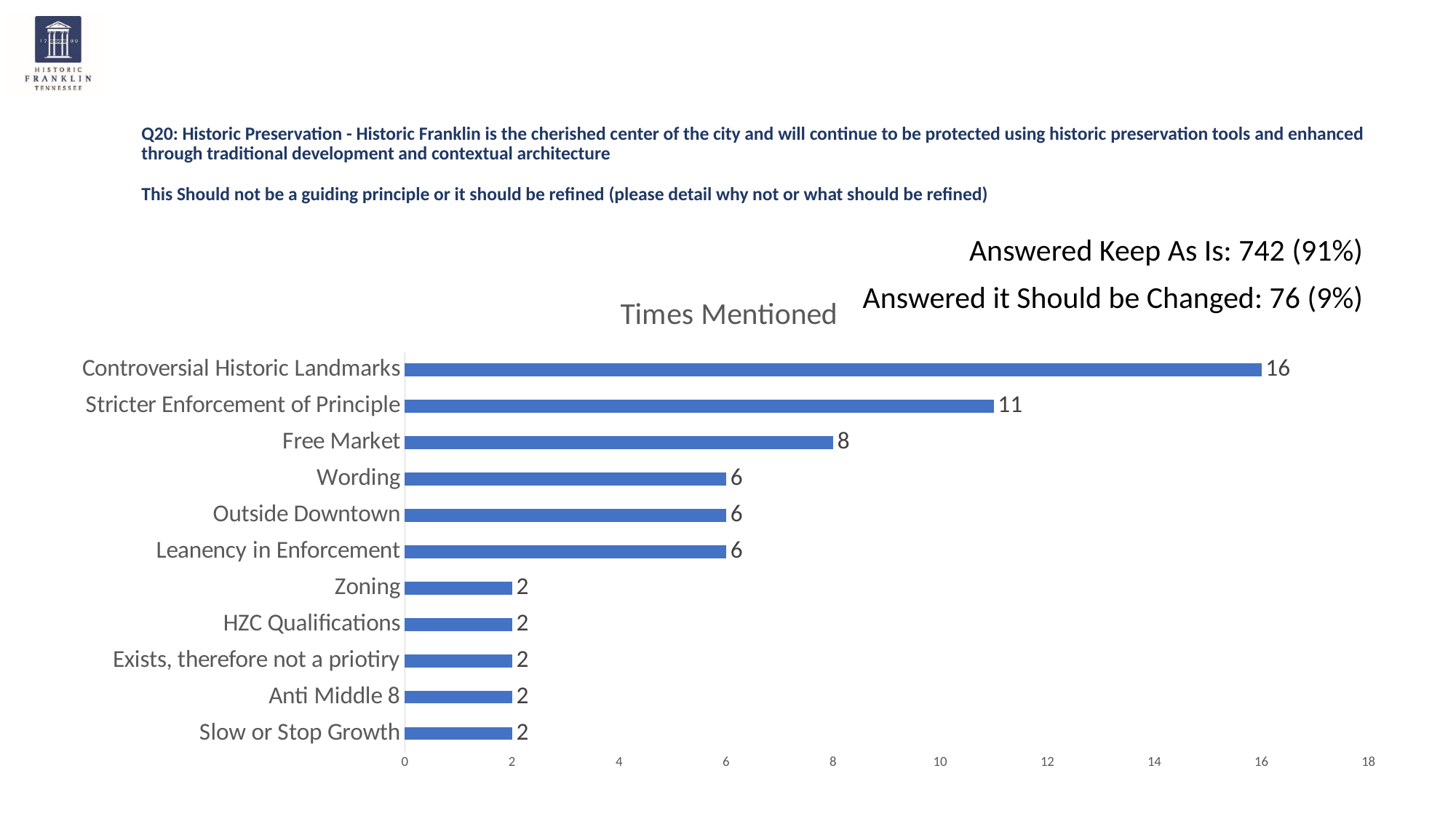
What is the difference between Controversial Historic Landmarks and Stricter Enforcement of Principle? 5 What kind of chart is shown on the slide? bar chart Is the value for Stricter Enforcement of Principle greater or less than 10? greater What is the difference between Free Market and Outside Downtown? 2 What is the value for Stricter Enforcement of Principle? 11 How many categories are shown in the chart? 11 What is the value for Controversial Historic Landmarks? 16 Which is larger, Free Market or Wording? Free Market What is the value for Zoning? 2 Which category has the highest number of times mentioned? Controversial Historic Landmarks How many times was Free Market mentioned? 8 What is the title of the chart? Times Mentioned